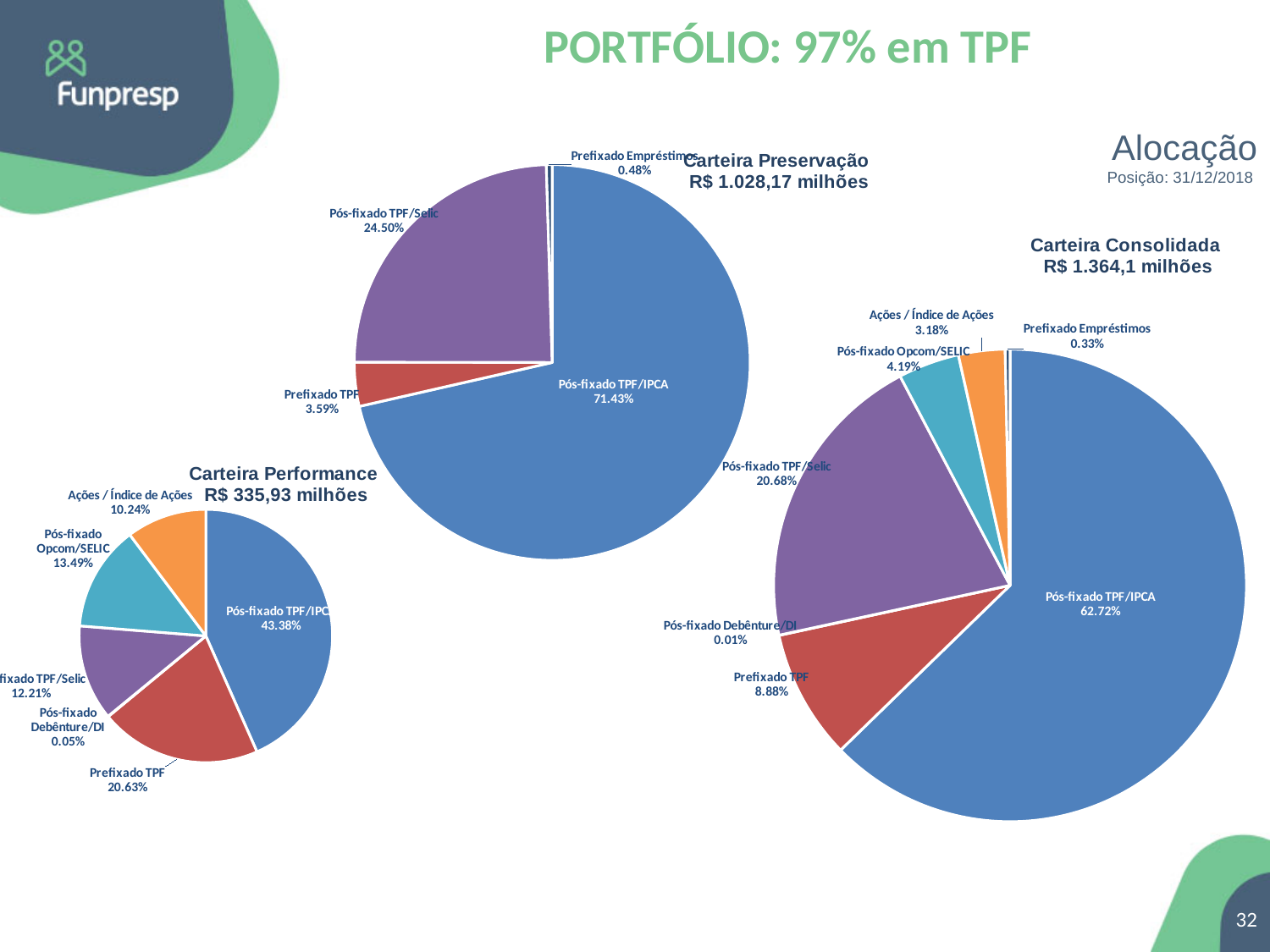
In the Carteira Performance chart, which category has the largest share? Pós-fixado TPF/IPCA In the Carteira Performance chart, what share does Prefixado TPF have? 20.63% What kind of chart is used for Carteira Consolidada? Pie chart In the Carteira Preservação chart, what share does Pós-fixado TPF/Selic have? 24.50% In the Carteira Consolidada chart, what is the difference between the shares of Pós-fixado TPF/IPCA and Prefixado TPF? 53.84% In the Carteira Performance chart, how many slices are there? 6 In the Carteira Performance chart, which is larger: Pós-fixado Opcom/SELIC or Ações / Índice de Ações? Pós-fixado Opcom/SELIC In the Carteira Preservação chart, what share does Pós-fixado TPF/IPCA have? 71.43% In the Carteira Consolidada chart, how many slices are there? 7 What total value is shown in the title of the Carteira Consolidada chart? R$ 1.364,1 milhões In the Carteira Consolidada chart, what share does Pós-fixado TPF/Selic have? 20.68% In the Carteira Preservação chart, which category has the smallest share? Prefixado Empréstimos